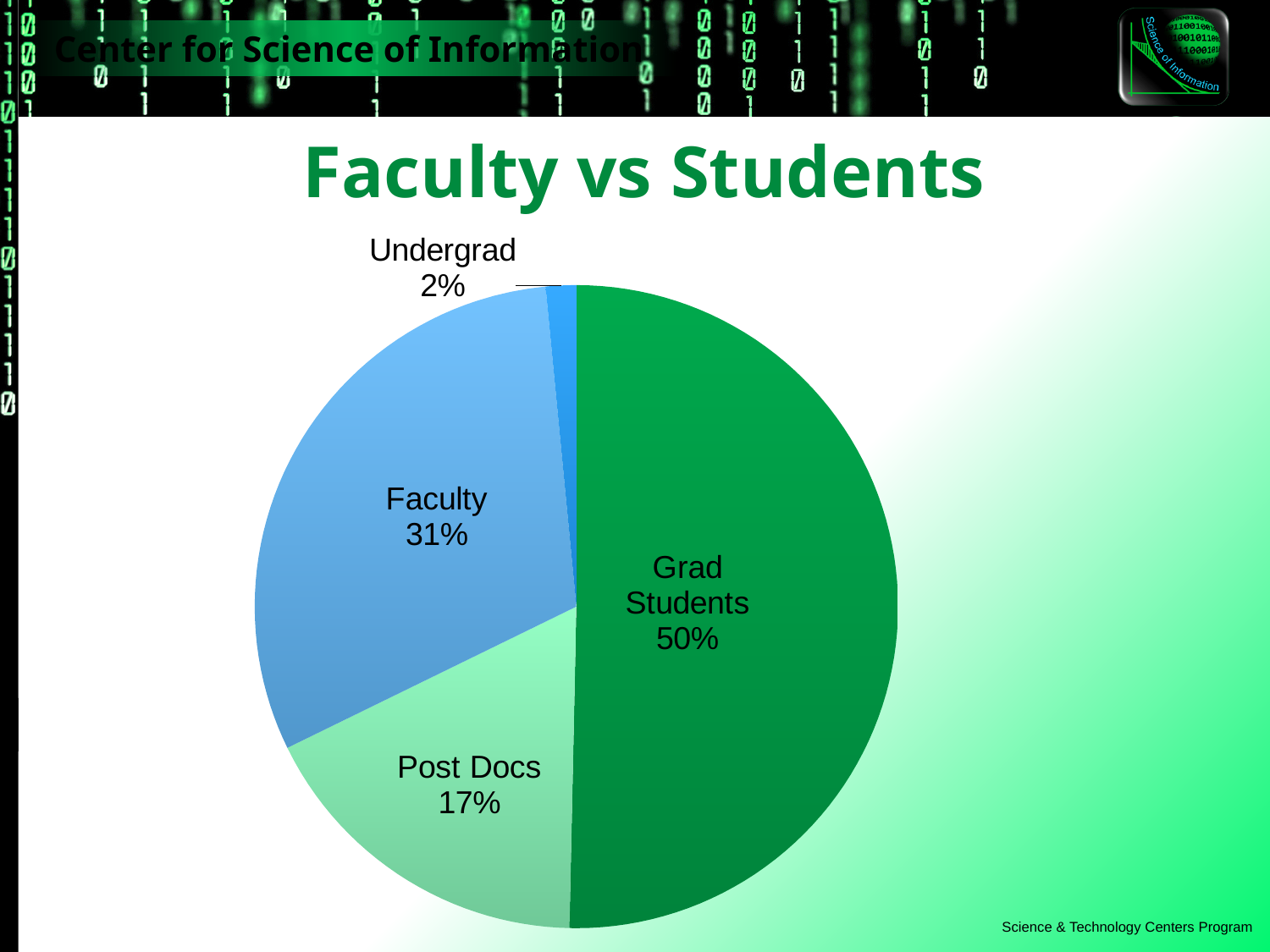
What is the difference in percentage points between Grad Students and Faculty? 19 What percentage is shown for Undergrad? 2% What percentage is shown for Post Docs? 17% What is the title of the chart? Faculty vs Students What share of the pie do Grad Students represent? 50% What percentage is shown for Faculty? 31% Which is larger, the Faculty slice or the Post Docs slice? Faculty Which category has the largest slice of the pie? Grad Students What is the difference in percentage points between Faculty and Post Docs? 14 Which category has the smallest slice of the pie? Undergrad What kind of chart is shown on the slide? pie chart How many categories are shown in the pie chart? 4